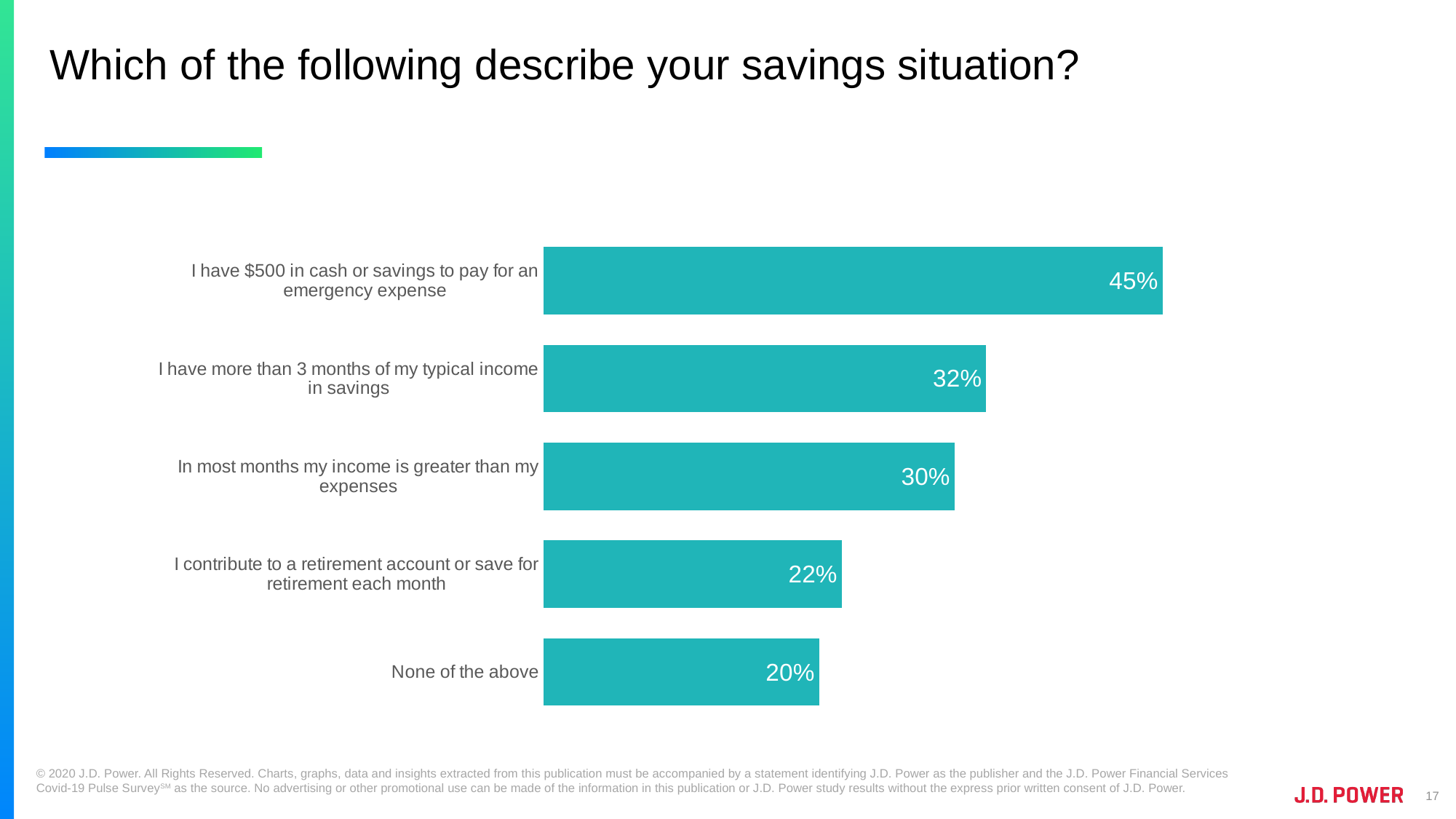
What type of chart is shown on the slide? Bar chart What percentage of respondents said they have $500 in cash or savings to pay for an emergency expense? 45% What is the difference between the percentage for 'I have more than 3 months of my typical income in savings' and 'I contribute to a retirement account or save for retirement each month'? 10 percentage points What percentage of respondents said they contribute to a retirement account or save for retirement each month? 22% What is the difference in percentage points between 'I have $500 in cash or savings to pay for an emergency expense' and 'None of the above'? 25 percentage points What percentage of respondents said that in most months their income is greater than their expenses? 30% Which savings situation has the highest percentage of respondents? I have $500 in cash or savings to pay for an emergency expense What percentage of respondents selected 'None of the above'? 20% How many response categories are shown in the chart? 5 Which is larger: the percentage for 'I have more than 3 months of my typical income in savings' or 'In most months my income is greater than my expenses'? I have more than 3 months of my typical income in savings What percentage of respondents said they have more than 3 months of their typical income in savings? 32% Which response option has the lowest percentage? None of the above